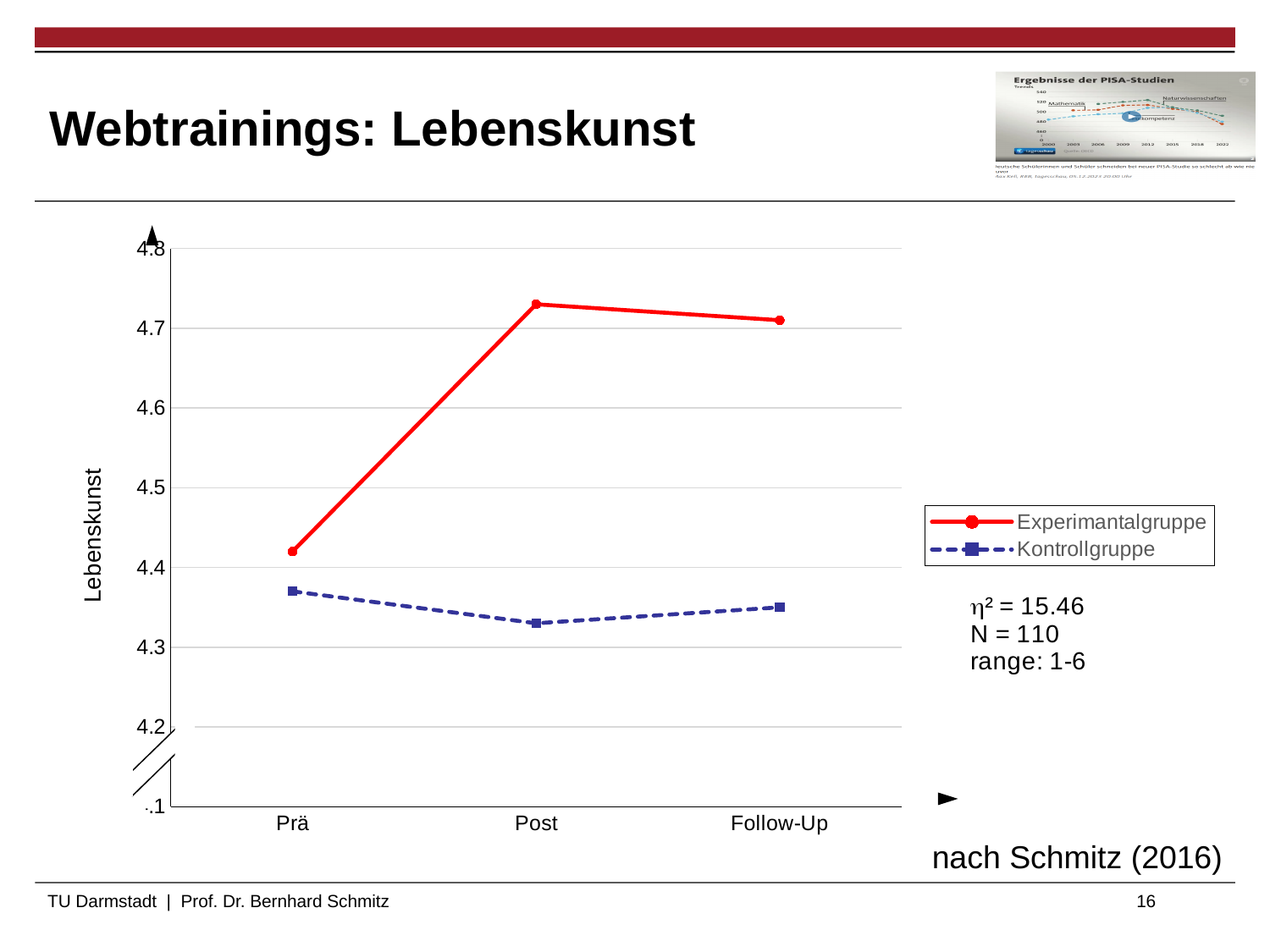
What is the label of the y axis? Lebenskunst What kind of chart is shown on the slide? line chart How many measurement points are shown along the x axis? 3 At Post, which group has the higher value, Experimantalgruppe or Kontrollgruppe? Experimantalgruppe Is the value for the Experimantalgruppe at Post greater or less than 4.6? greater Is the value for the Kontrollgruppe at Post greater or less than 4.4? less Is the value for the Experimantalgruppe at Follow-Up greater or less than 4.6? greater Which series is drawn with a dashed line? Kontrollgruppe How many series does the legend list? 2 At which measurement point is the Experimantalgruppe value lowest? Prä Does the Experimantalgruppe value rise or fall from Prä to Post? rise